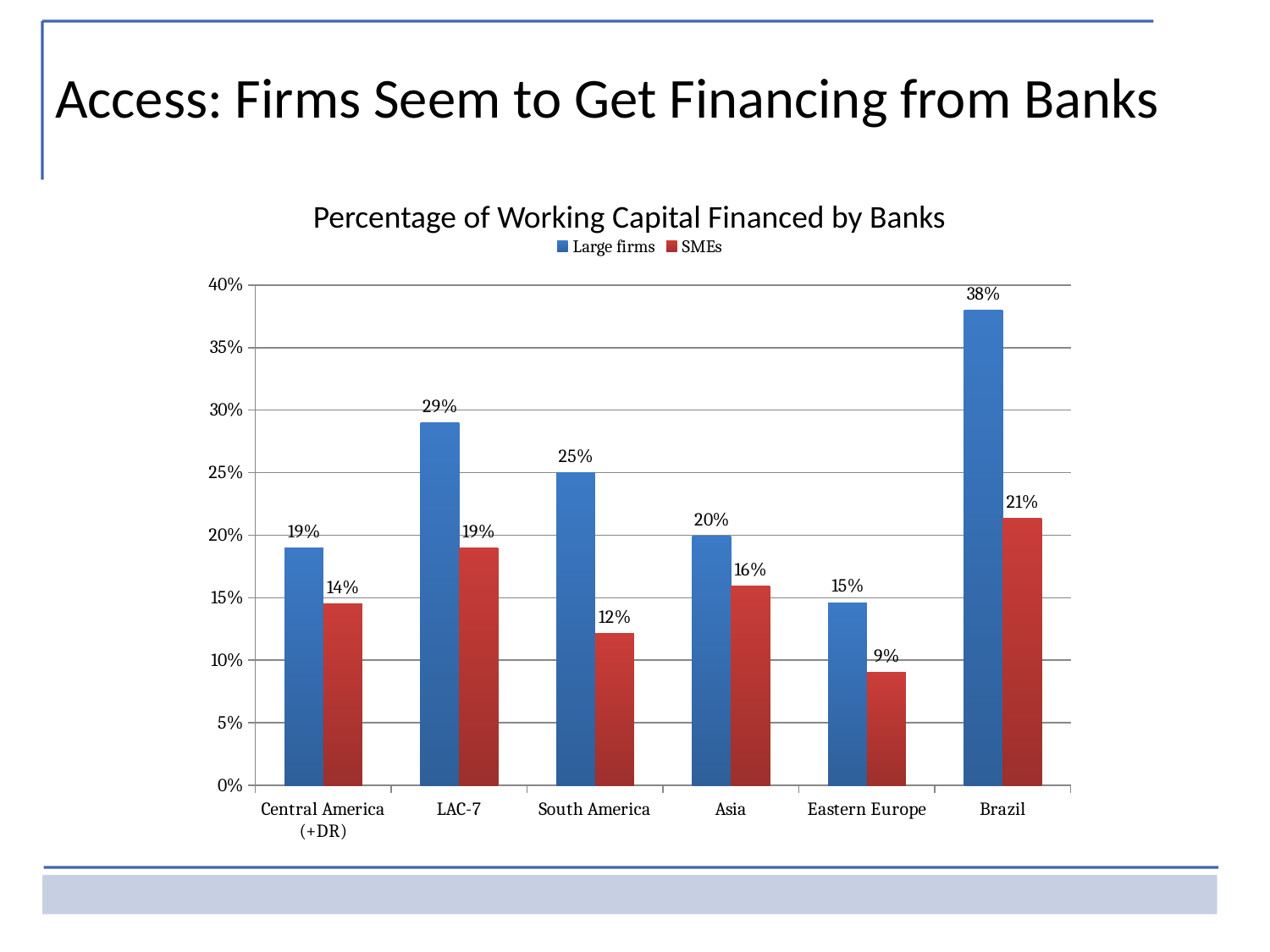
What is the value for SMEs in South America? 12% What is the value for Large firms in Brazil? 38% What is the title of the chart? Percentage of Working Capital Financed by Banks What is the difference between the Large firms and SMEs values in South America? 13% What is the value for SMEs in Eastern Europe? 9% Which region has the highest value for Large firms? Brazil Which is larger: the Large firms value for LAC-7 or the Large firms value for Asia? LAC-7 What kind of chart is shown on the slide? Bar chart Is the value for Large firms in Brazil greater or less than 35%? greater How many series does the legend list? 2 How many regions are shown on the x axis? 6 Which region has the lowest value for SMEs? Eastern Europe